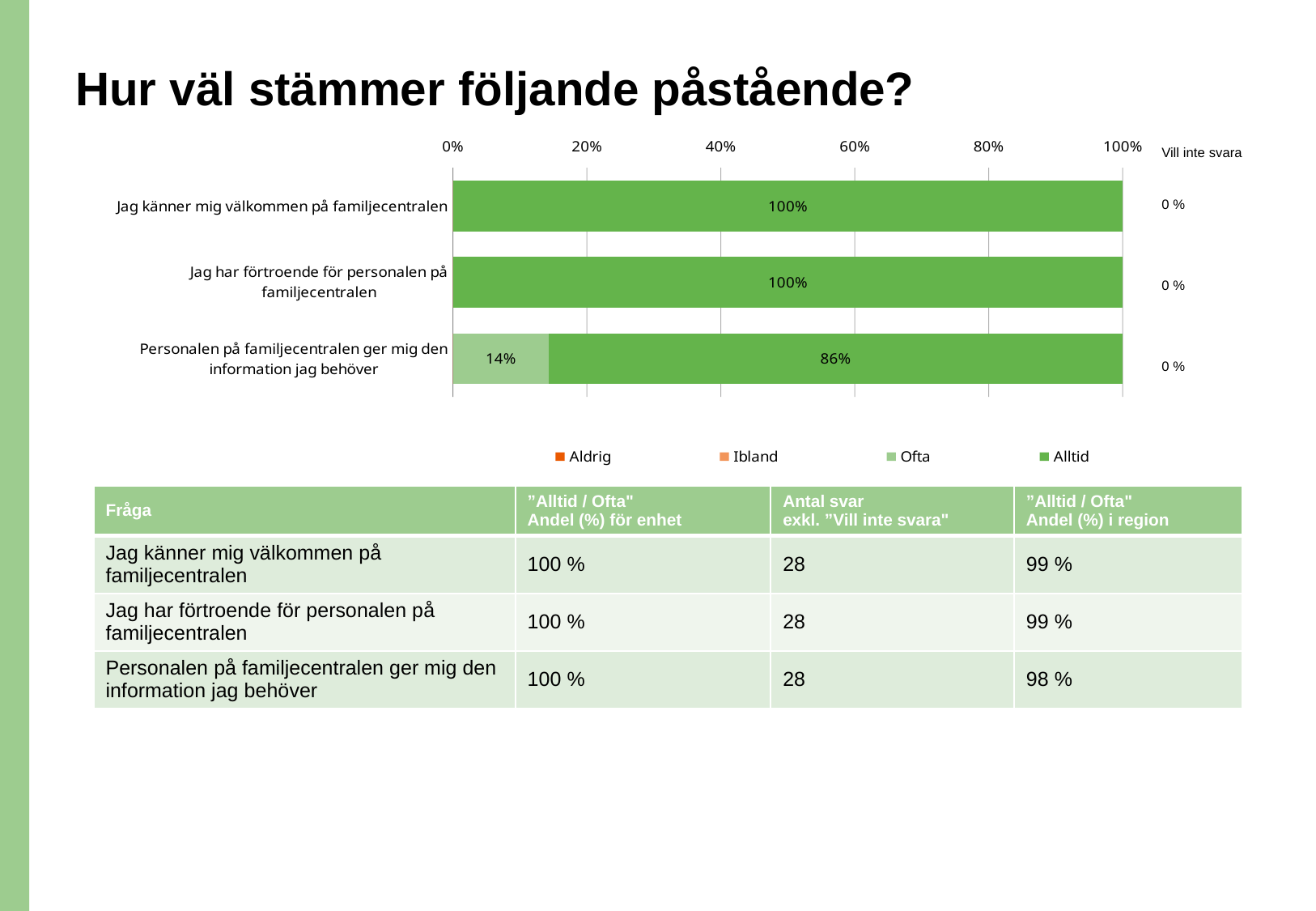
How many series does the chart legend list? 4 What is the value of the "Ofta" series for "Personalen på familjecentralen ger mig den information jag behöver"? 14% Which category has the lowest "Alltid" value? Personalen på familjecentralen ger mig den information jag behöver What is the value of the "Alltid" series for "Personalen på familjecentralen ger mig den information jag behöver"? 86% What is the difference between the "Alltid" and "Ofta" values for "Personalen på familjecentralen ger mig den information jag behöver"? 72% Is the "Ofta" value for "Personalen på familjecentralen ger mig den information jag behöver" greater or less than 20%? less How many categories (statements) are shown in the chart? 3 What type of chart is shown on the slide? stacked bar chart Is the "Alltid" value for "Personalen på familjecentralen ger mig den information jag behöver" larger or smaller than the "Alltid" value for "Jag känner mig välkommen på familjecentralen"? smaller What is the "Vill inte svara" value shown next to the bar for "Jag har förtroende för personalen på familjecentralen"? 0 % What is the value of the "Alltid" series for "Jag har förtroende för personalen på familjecentralen"? 100% What is the value of the "Alltid" series for "Jag känner mig välkommen på familjecentralen"? 100%